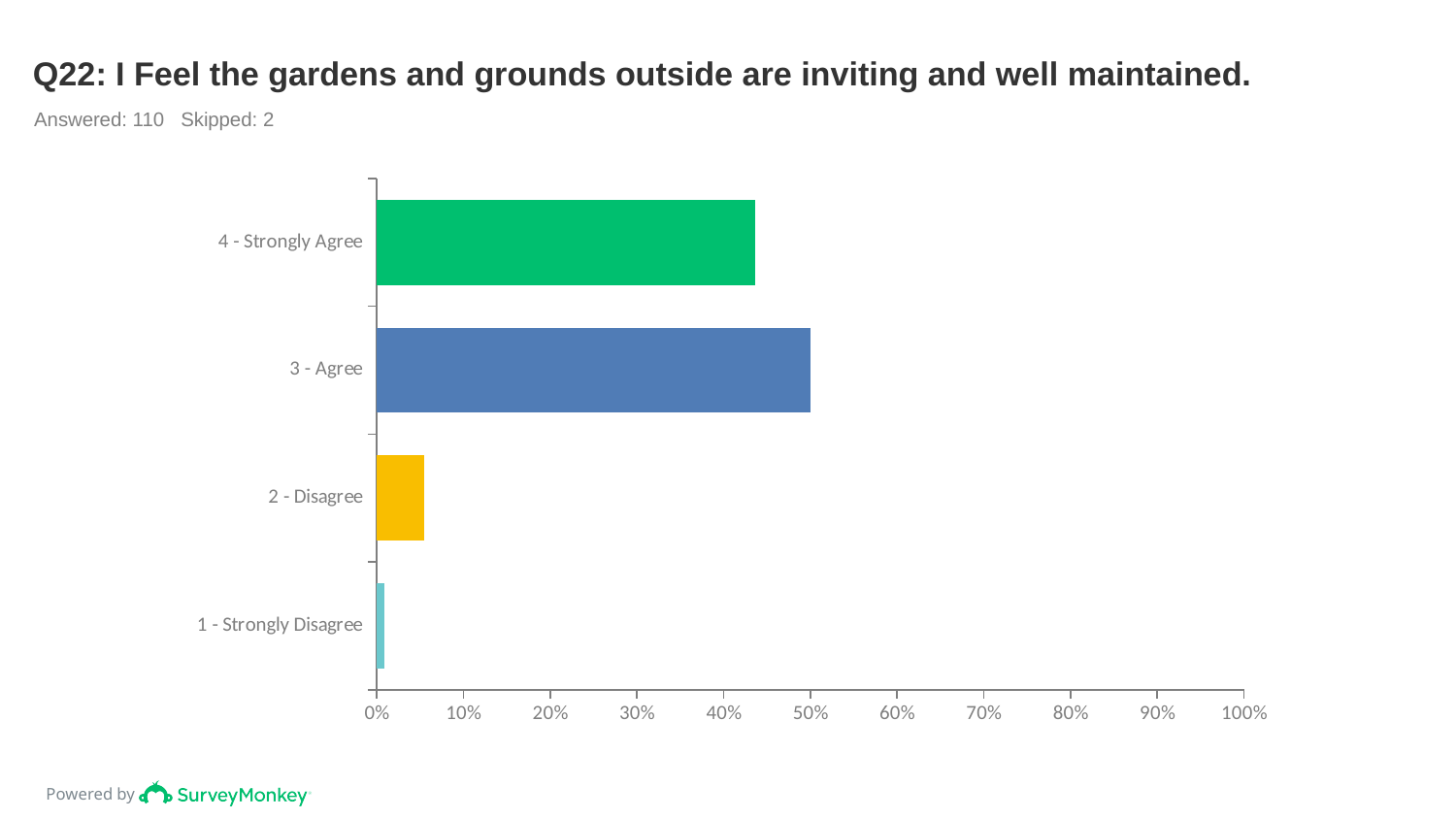
How many categories are plotted in the chart? 4 Is the value for 1 - Strongly Disagree greater or less than 10%? less Which category has the lowest value? 1 - Strongly Disagree Which category has the highest value? 3 - Agree What kind of chart is shown on the slide? bar chart Is the value for 4 - Strongly Agree greater or less than 50%? less What is the title of the chart? Q22: I Feel the gardens and grounds outside are inviting and well maintained. Is the value for 4 - Strongly Agree greater or less than 40%? greater What is the value for 3 - Agree? 50% Which is larger, the value for 4 - Strongly Agree or the value for 3 - Agree? 3 - Agree How many respondents answered the question according to the slide? 110